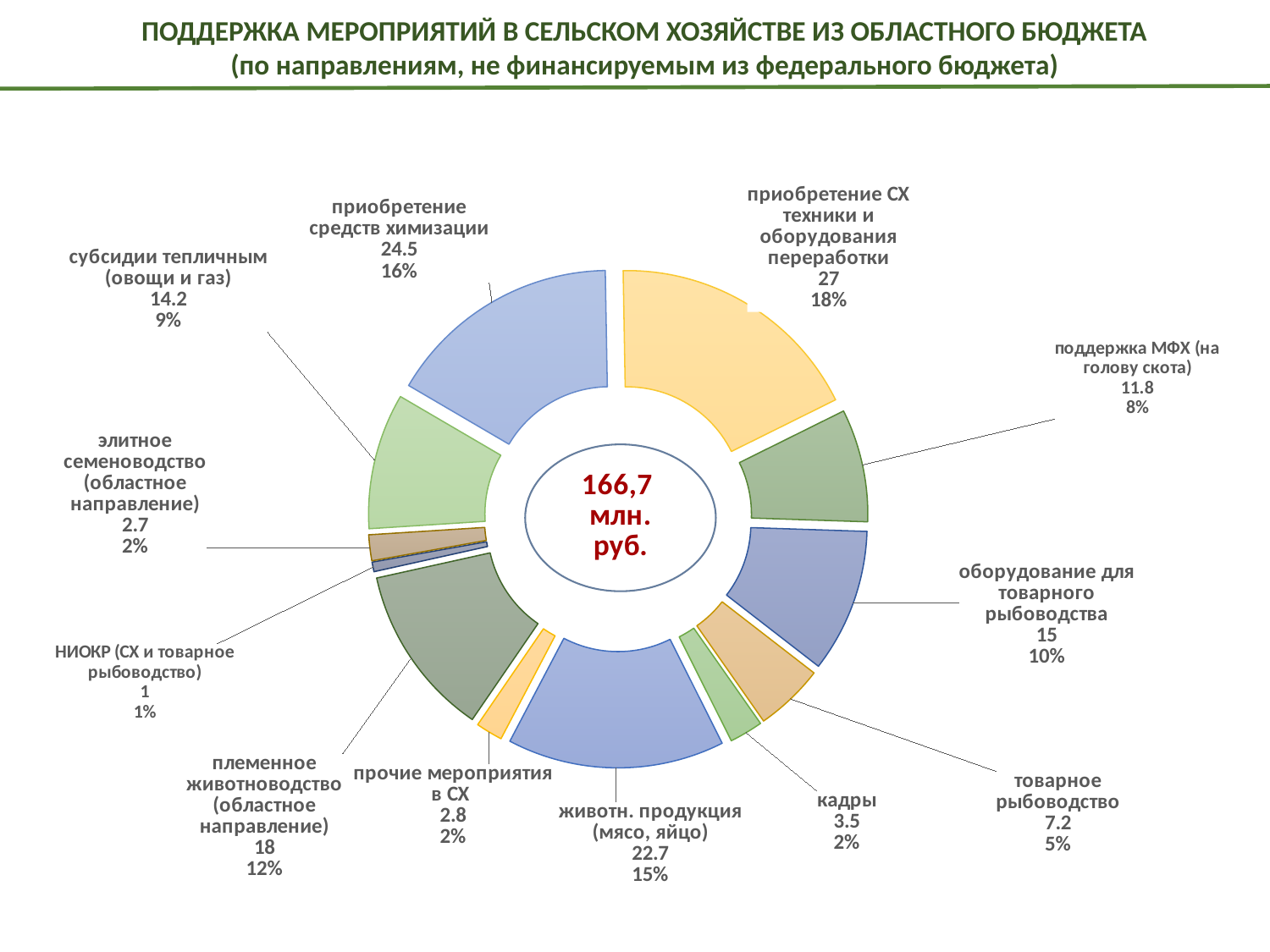
How many categories (slices) does the chart show? 12 Which is larger: «оборудование для товарного рыбоводства» or «товарное рыбоводство»? оборудование для товарного рыбоводства What share of the total does «поддержка МФХ (на голову скота)» represent? 8% What share of the total does «животн. продукция (мясо, яйцо)» account for? 15% Which category has the smallest value? НИОКР (СХ и товарное рыбоводство) What kind of chart is shown on the slide? doughnut (pie) chart Which category has the largest value? приобретение СХ техники и оборудования переработки What is the value for «племенное животноводство (областное направление)»? 18 What is the difference between the values for «приобретение средств химизации» and «субсидии тепличным (овощи и газ)»? 10.3 What is the value for «кадры»? 3.5 What is the value for «приобретение СХ техники и оборудования переработки»? 27 What total amount is shown in the centre of the chart? 166,7 млн. руб.